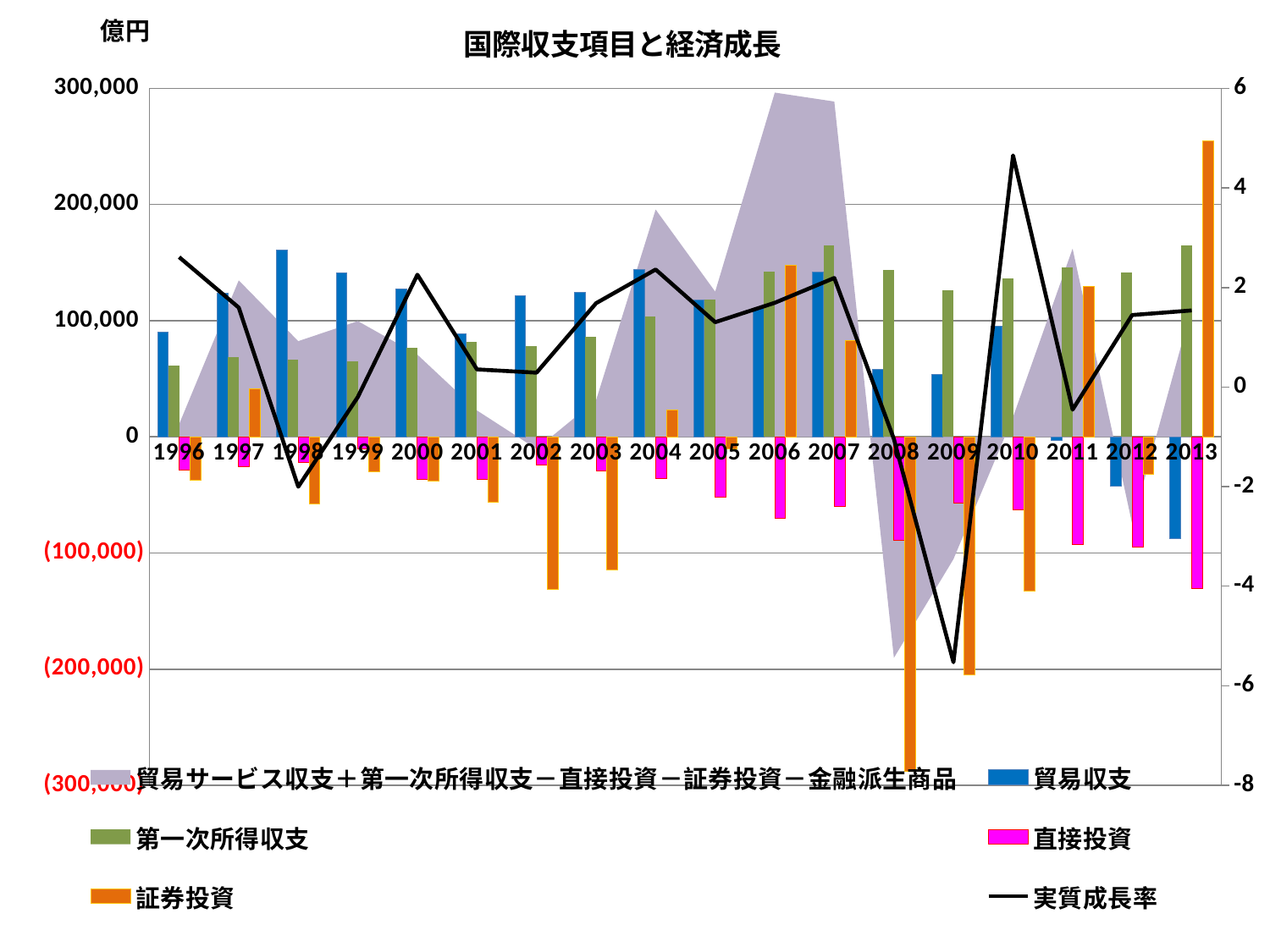
What is the title of the chart? 国際収支項目と経済成長 In which year is 証券投資 highest? 2013 Does 第一次所得収支 generally rise or fall from 1996 to 2013? rise Is the value for 直接投資 in 2013 greater or less than (100,000)? less How many years are shown on the x axis? 18 How many series does the legend list? 6 Is the value for 貿易収支 in 1998 greater or less than 100,000? greater In which year is 貿易収支 highest? 1998 What kind of chart is this? combination chart (bars, area and line) In which year is 実質成長率 lowest? 2009 In which year is 証券投資 lowest? 2008 Which is larger, 第一次所得収支 in 1996 or in 2013? 2013